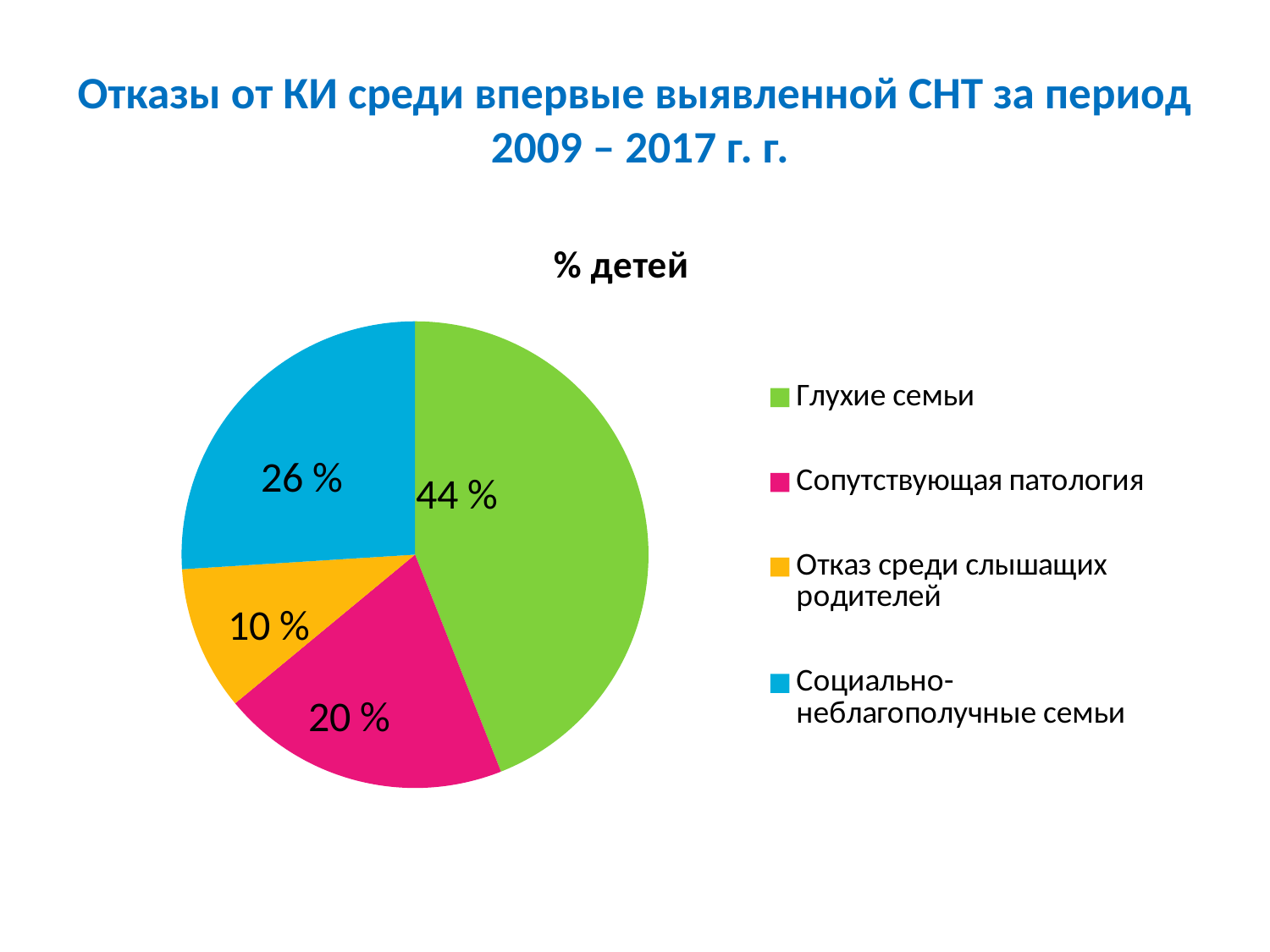
What kind of chart is shown on the slide? pie chart Which category has the largest slice? Глухие семьи How many categories does the pie chart show? 4 What is the value for Отказ среди слышащих родителей? 10 % What is the difference between the values for Глухие семьи and Социально-неблагополучные семьи? 18 % What colour is the slice for Сопутствующая патология? pink Which category has the smallest slice? Отказ среди слышащих родителей What is the value for Сопутствующая патология? 20 % What is the value for Глухие семьи? 44 % What is the value for Социально-неблагополучные семьи? 26 % Which is larger: Сопутствующая патология or Социально-неблагополучные семьи? Социально-неблагополучные семьи What is the title of the chart? % детей